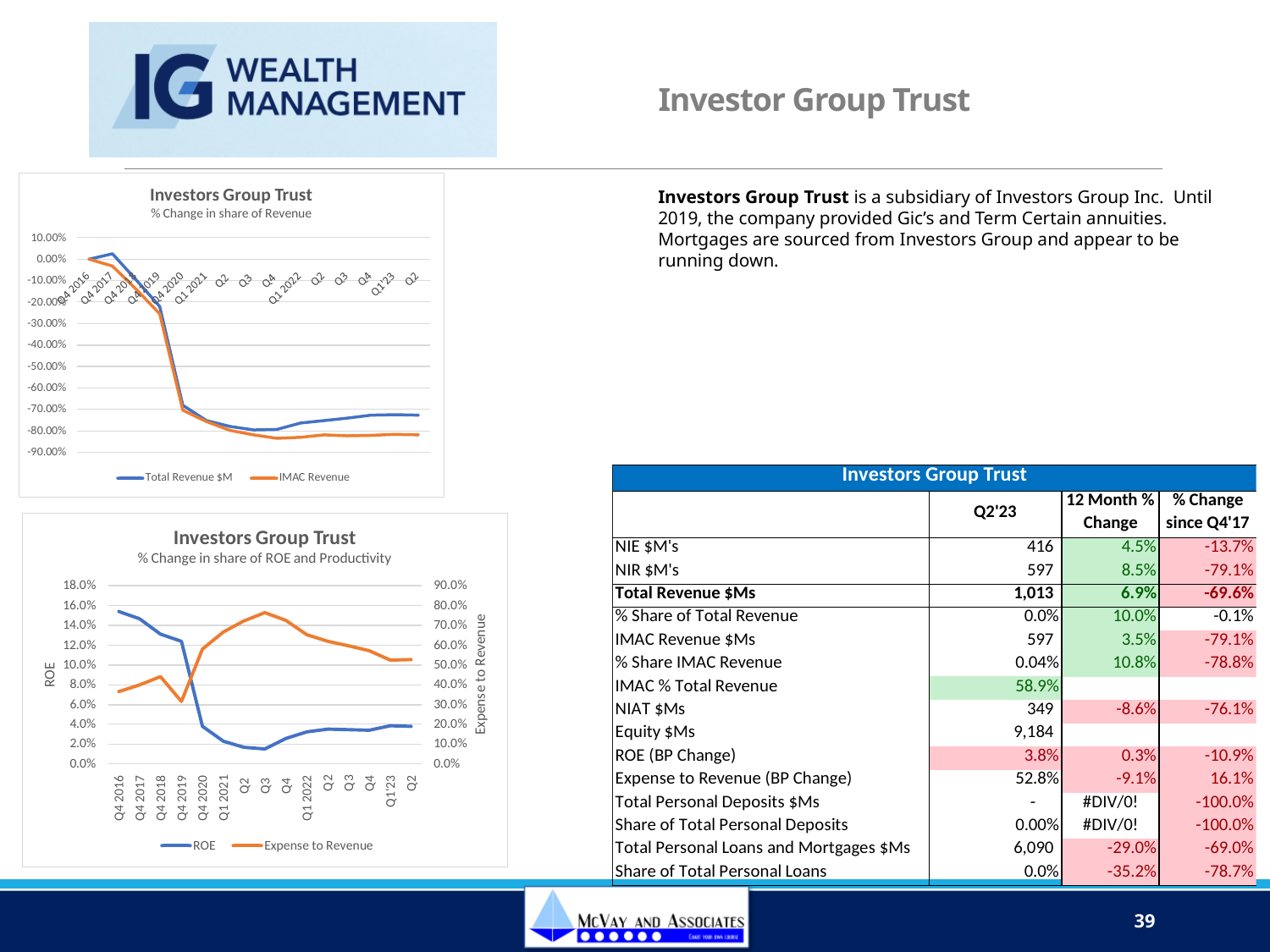
How many quarterly points are plotted along the x axis of the bottom-left chart (% Change in share of ROE and Productivity)? 15 In the top-left chart (% Change in share of Revenue), do the values generally rise or fall from Q4 2017 to Q4 2020? Fall What are the two series named in the legend of the top-left chart (% Change in share of Revenue)? Total Revenue $M and IMAC Revenue How many series does the legend of the bottom-left chart (% Change in share of ROE and Productivity) list? 2 In the bottom-left chart (% Change in share of ROE and Productivity), is the Expense to Revenue value at Q3 2021 greater or less than 70.0%? greater In the bottom-left chart (% Change in share of ROE and Productivity), is the ROE value at Q4 2016 greater or less than 14.0%? greater How many series does the legend of the top-left chart (% Change in share of Revenue) list? 2 In the top-left chart (% Change in share of Revenue), at the last point (Q2), which series is higher: Total Revenue $M or IMAC Revenue? Total Revenue $M What is the label on the right-hand vertical axis of the bottom-left chart (% Change in share of ROE and Productivity)? Expense to Revenue What kind of chart is the top-left chart titled 'Investors Group Trust – % Change in share of Revenue'? Line chart In the bottom-left chart (% Change in share of ROE and Productivity), does the ROE series rise or fall overall from Q4 2016 to Q2'23? Fall In the top-left chart (% Change in share of Revenue), is the Total Revenue $M value at the last point (Q2) greater or less than -60.00%? less